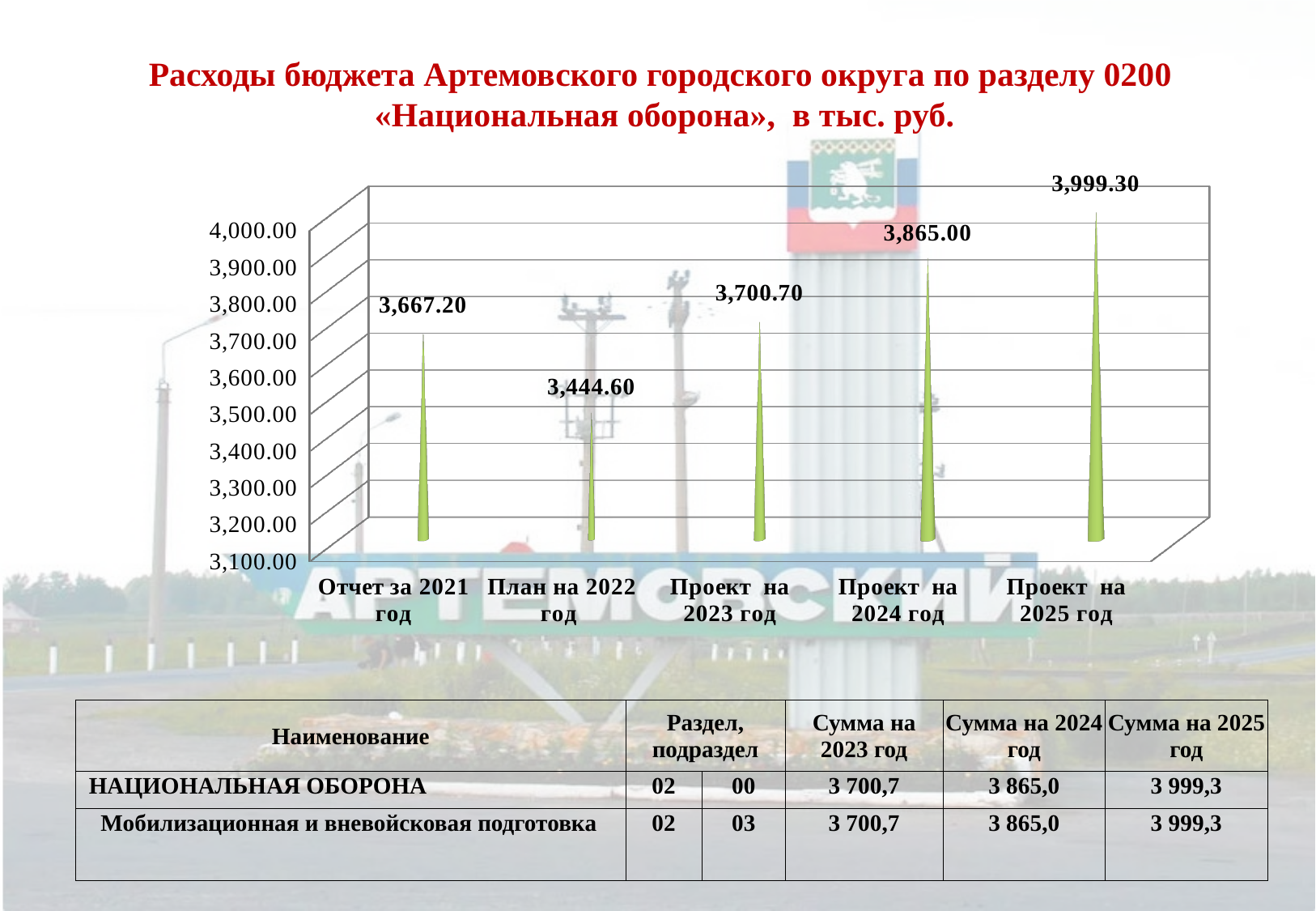
What is the value for «Отчет за 2021 год»? 3,667.20 What is the value for «План на 2022 год»? 3,444.60 How many categories are shown on the x axis of the chart? 5 Which is larger: the value for «Отчет за 2021 год» or the value for «Проект на 2023 год»? Проект на 2023 год What is the title of the chart on the slide? Расходы бюджета Артемовского городского округа по разделу 0200 «Национальная оборона», в тыс. руб. What is the difference between the values for «Проект на 2025 год» and «Проект на 2024 год»? 134.30 What kind of chart is shown on the slide? bar chart Which category has the lowest value? План на 2022 год Which category has the highest value? Проект на 2025 год What is the value for «Проект на 2024 год»? 3,865.00 Do the values rise or fall from «Проект на 2023 год» to «Проект на 2025 год»? rise What is the difference between the values for «Проект на 2023 год» and «План на 2022 год»? 256.10